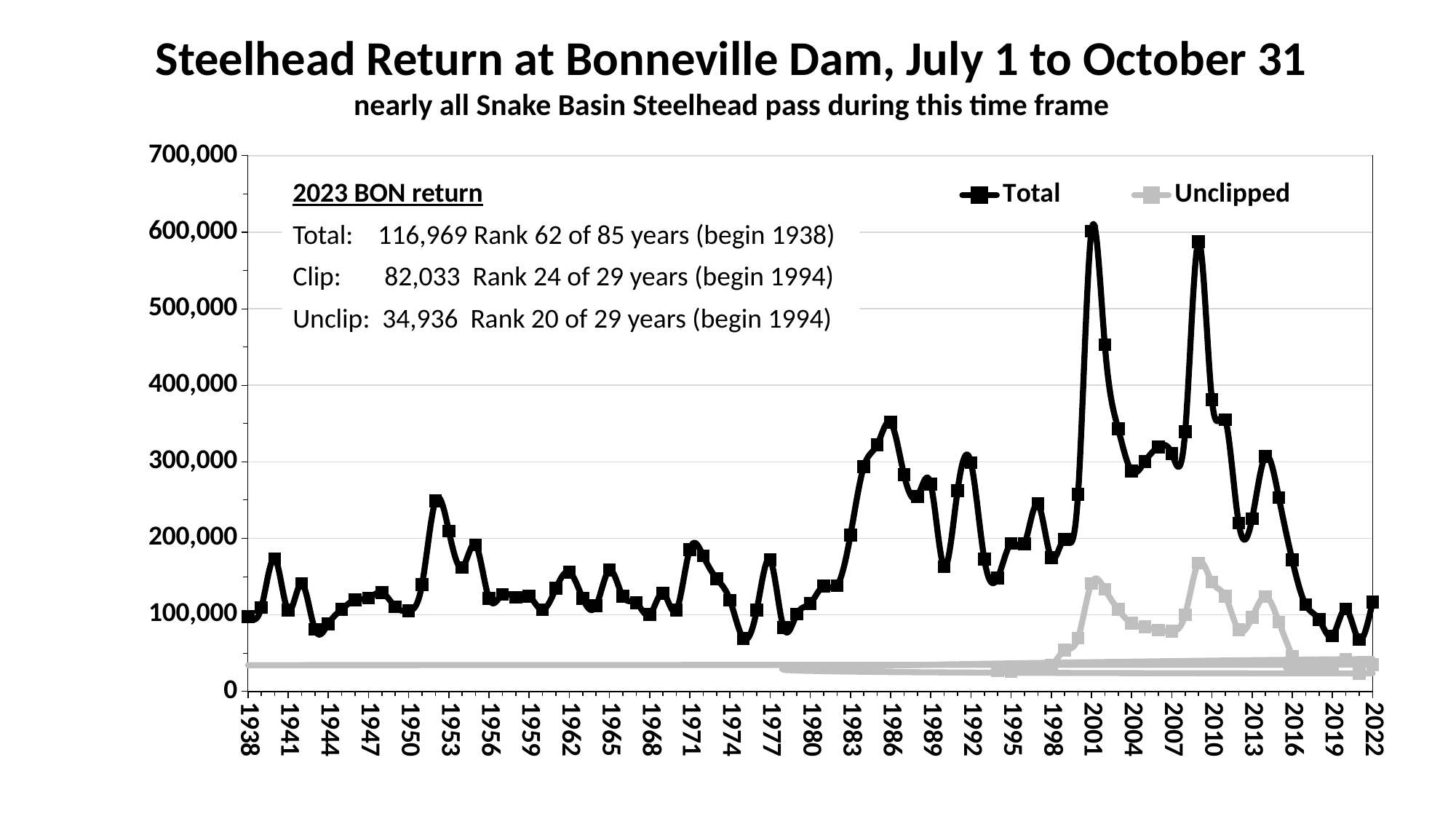
Is the Unclipped value for 2009 greater or less than 100,000? greater Which is larger, the Total value for 2001 or the Total value for 1938? 2001 In 2009, which series has the larger value, Total or Unclipped? Total According to the text box, what was the 2023 BON total return? 116,969 Does the Total series rise or fall from 2015 to 2019? fall Is the Total value for 2001 greater or less than 500,000? greater What kind of chart is shown on the slide? line chart How many series does the legend list? 2 Is the Unclipped value for 2020 greater or less than 100,000? less What are the two series named in the legend? Total and Unclipped